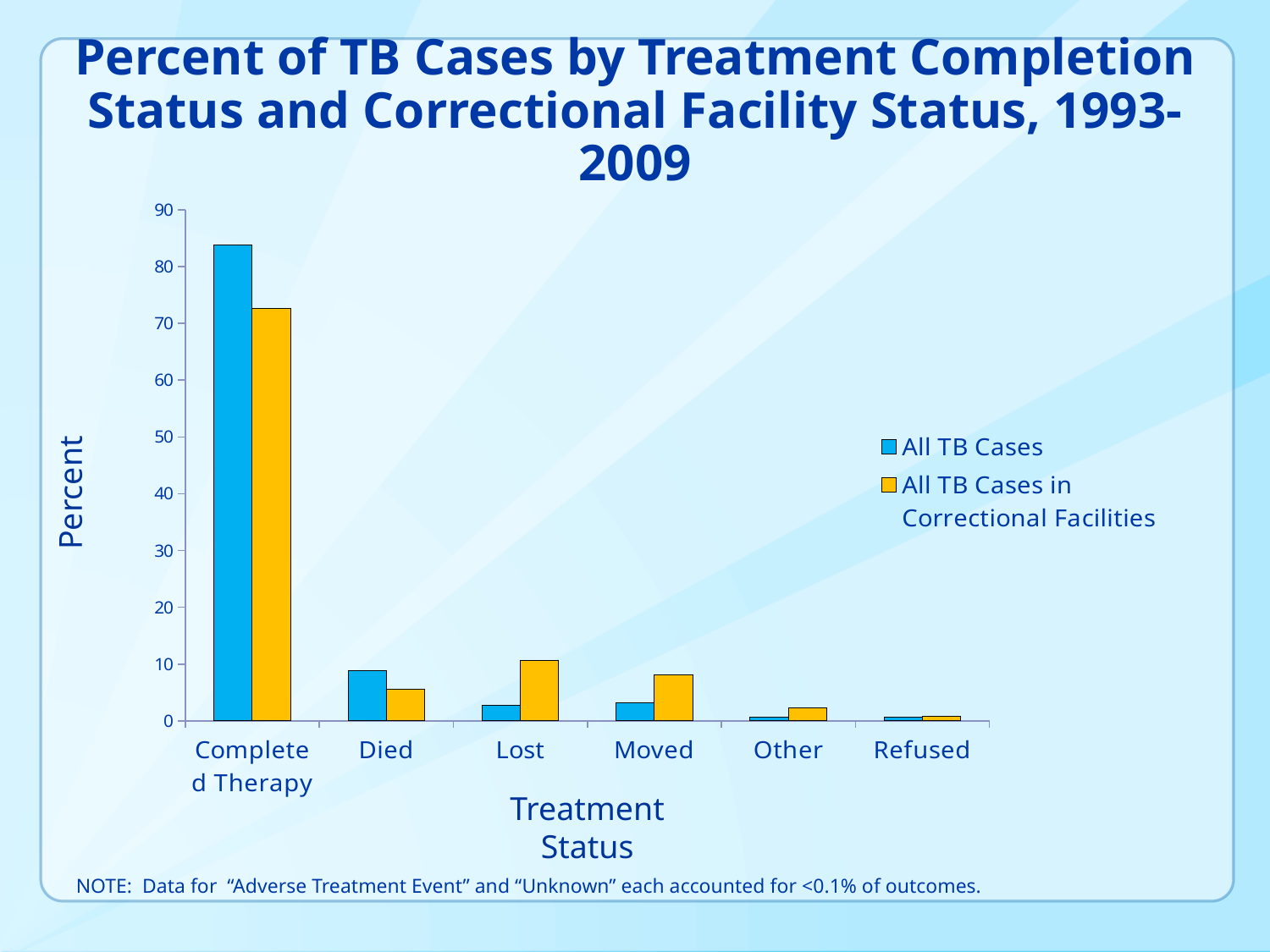
Is the value for All TB Cases in Correctional Facilities in the Completed Therapy category greater or less than 80? less How many treatment status categories are shown on the x axis? 6 Is the value for All TB Cases in Correctional Facilities in the Moved category greater or less than 10? less How many series does the legend list? 2 For the All TB Cases in Correctional Facilities series, which treatment status has the highest percent? Completed Therapy For Died, which series has the larger value: All TB Cases or All TB Cases in Correctional Facilities? All TB Cases What kind of chart is shown on the slide? bar chart Is the value for All TB Cases in the Completed Therapy category greater or less than 80? greater For Completed Therapy, which series has the larger value: All TB Cases or All TB Cases in Correctional Facilities? All TB Cases What is the label on the y axis of the chart? Percent For the All TB Cases series, which treatment status has the highest percent? Completed Therapy For Lost, which series has the larger value: All TB Cases or All TB Cases in Correctional Facilities? All TB Cases in Correctional Facilities